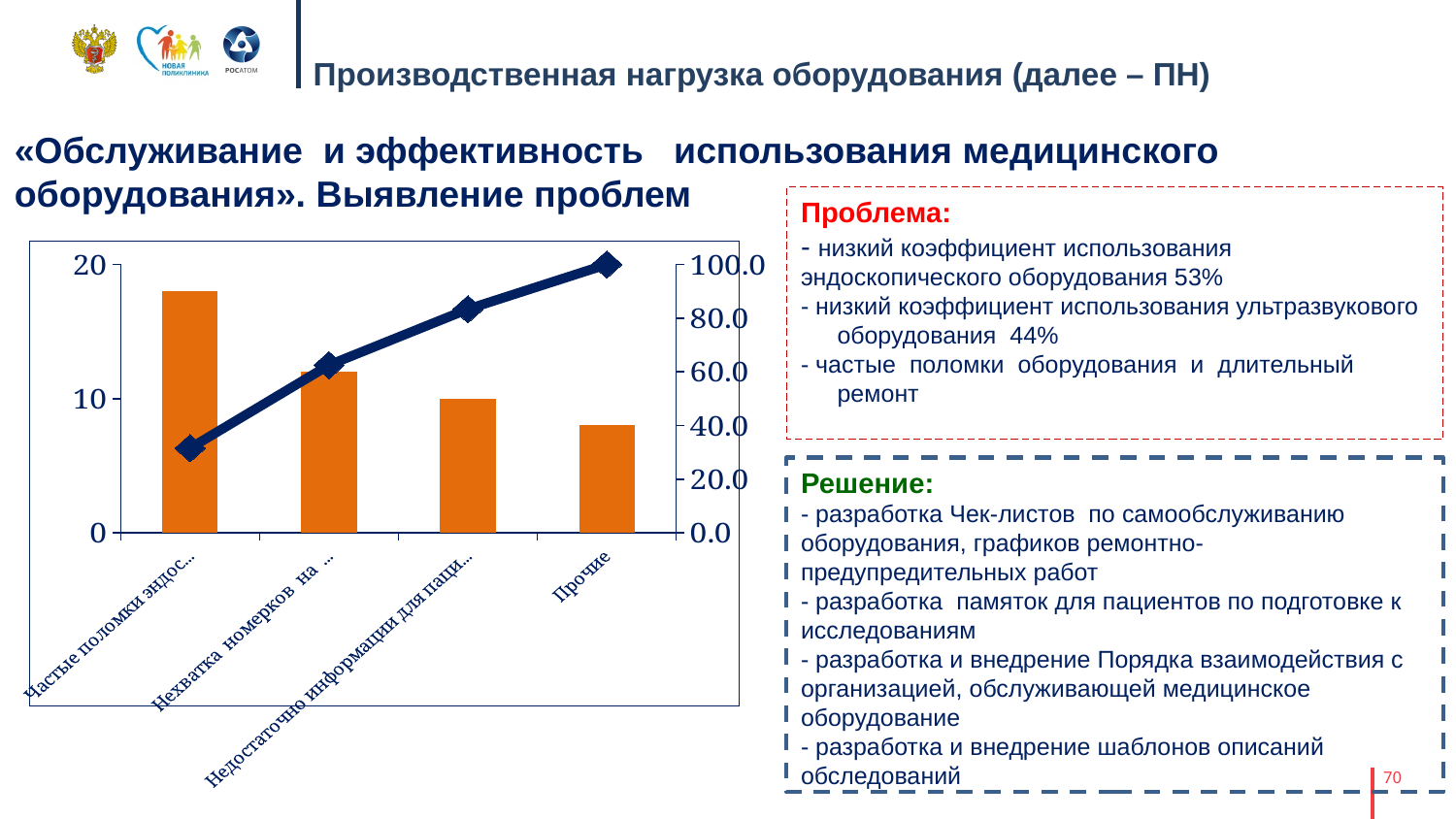
Which bar is taller: "Нехватка номерков на ..." or "Прочие"? Нехватка номерков на ... Does the line rise or fall from left to right along the x axis? rise What kind of chart is shown on the slide? Combined bar and line chart Is the bar value for "Частые поломки эндос..." greater or less than 10? greater Is the line value for "Частые поломки эндос..." on the right axis greater or less than 40.0? less Is the bar value for "Прочие" greater or less than 10? less What is the line value for "Прочие" on the right axis? 100.0 Which category has the shortest bar in the chart? Прочие Do the bar values rise or fall from left to right along the x axis? fall Which category has the tallest bar in the chart? Частые поломки эндос... How many categories are shown on the x axis of the chart? 4